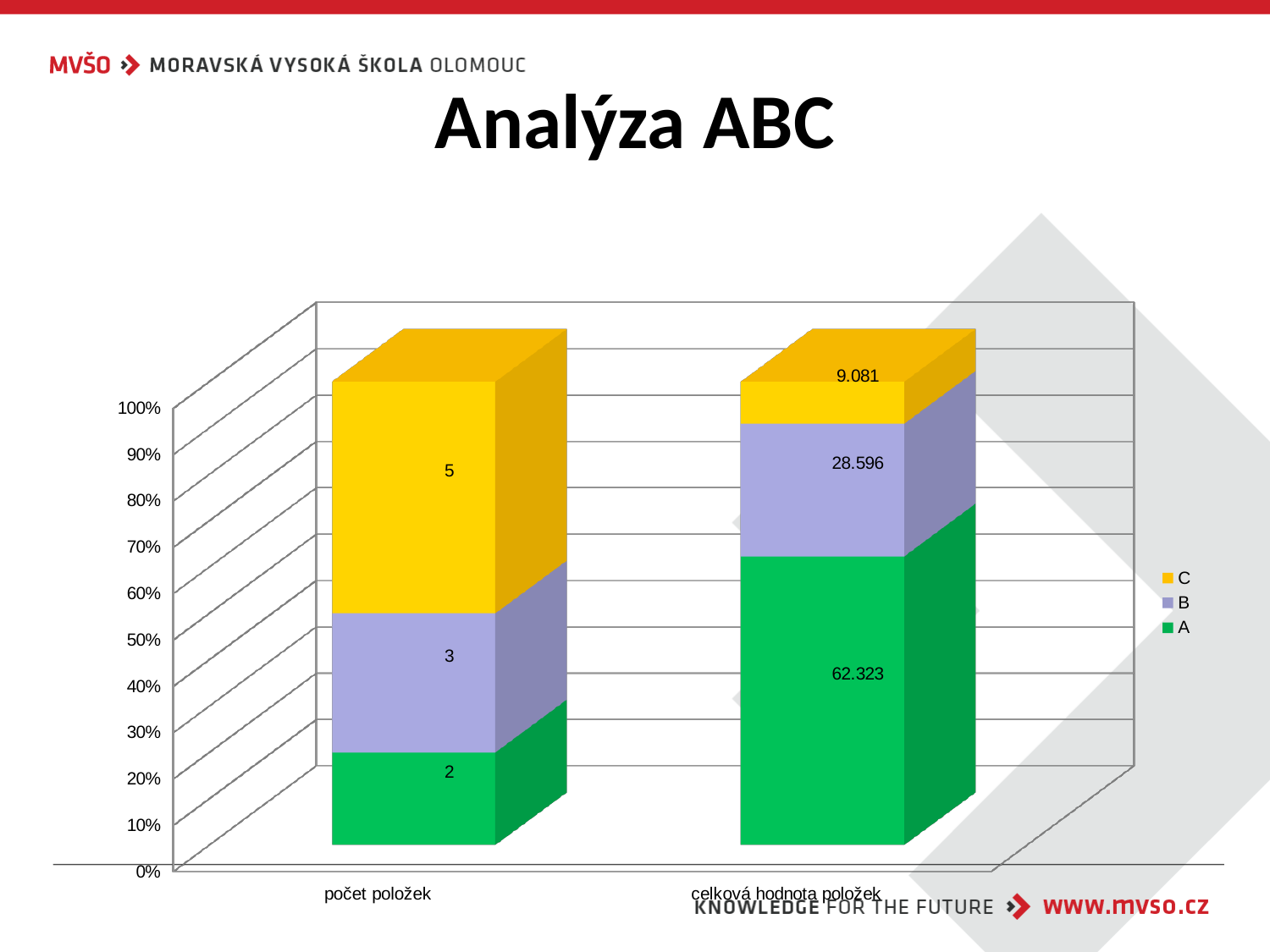
Which series has the largest value for celková hodnota položek? A What is the value of series C for celková hodnota položek? 9.081 For počet položek, which is larger: series B or series C? C What is the value of series C for počet položek? 5 What is the total of the stacked bar for počet položek? 10 What kind of chart is shown on the slide? Stacked bar chart How many series does the legend list? 3 What is the value of series B for celková hodnota položek? 28.596 What is the difference between the values of series C and series B for počet položek? 2 What is the value of series A for počet položek? 2 Which series has the smallest value for počet položek? A What is the value of series A for celková hodnota položek? 62.323